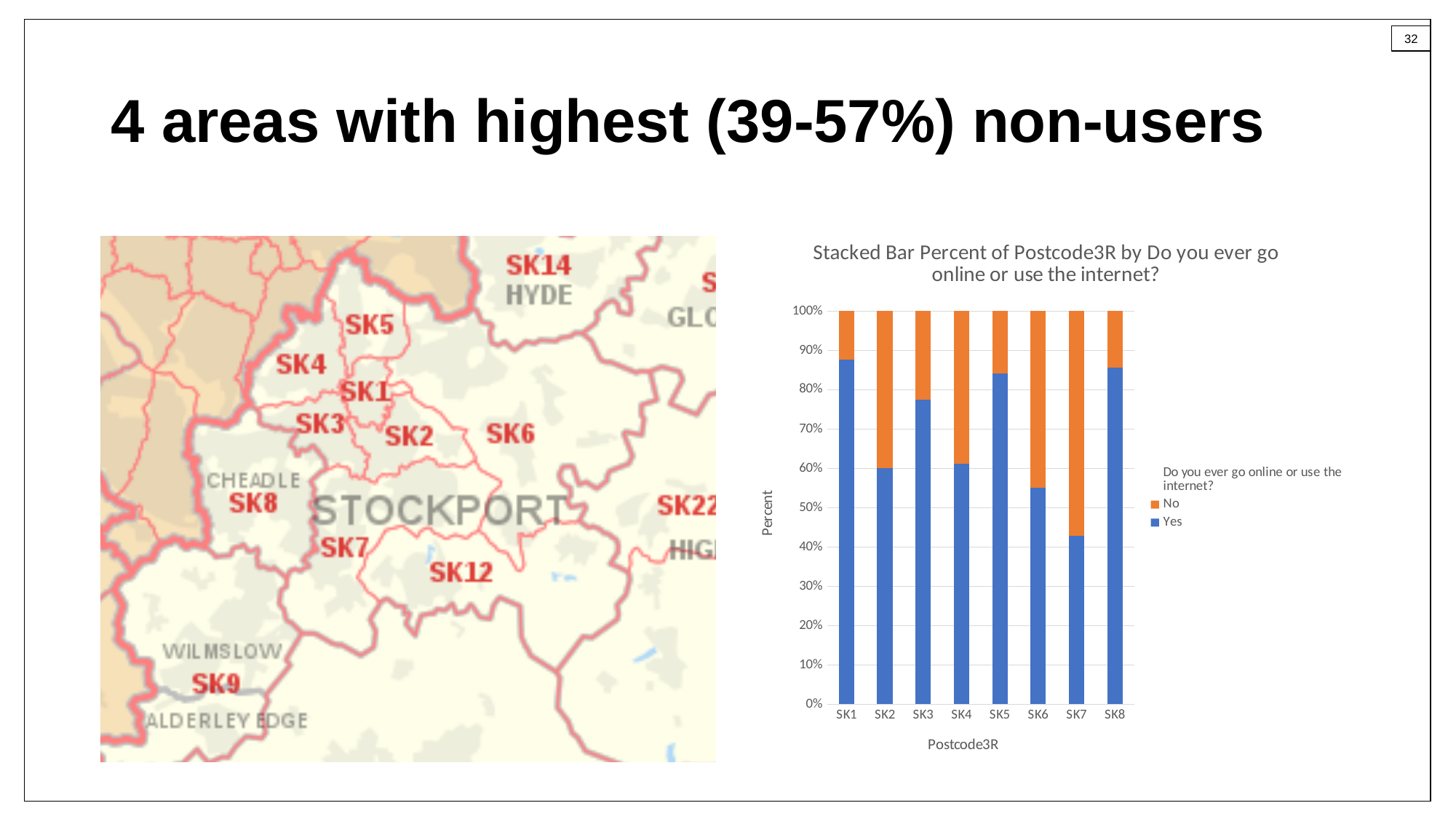
Which postcode has the largest 'No' share in the chart? SK7 What is the label of the chart's x axis? Postcode3R Which has the larger 'Yes' share, SK3 or SK6? SK3 Is the 'Yes' value for SK6 greater or less than 60%? less What kind of chart is shown on the slide? stacked bar chart How many postcode categories are plotted on the x axis of the chart? 8 How many series does the chart's legend list? 2 Which postcode has the lowest 'Yes' share in the chart? SK7 Is the 'Yes' value for SK1 greater or less than 80%? greater Which legend entry is shown in orange? No Is the 'Yes' value for SK7 greater or less than 50%? less What is the total height of the stacked bar for SK4? 100%